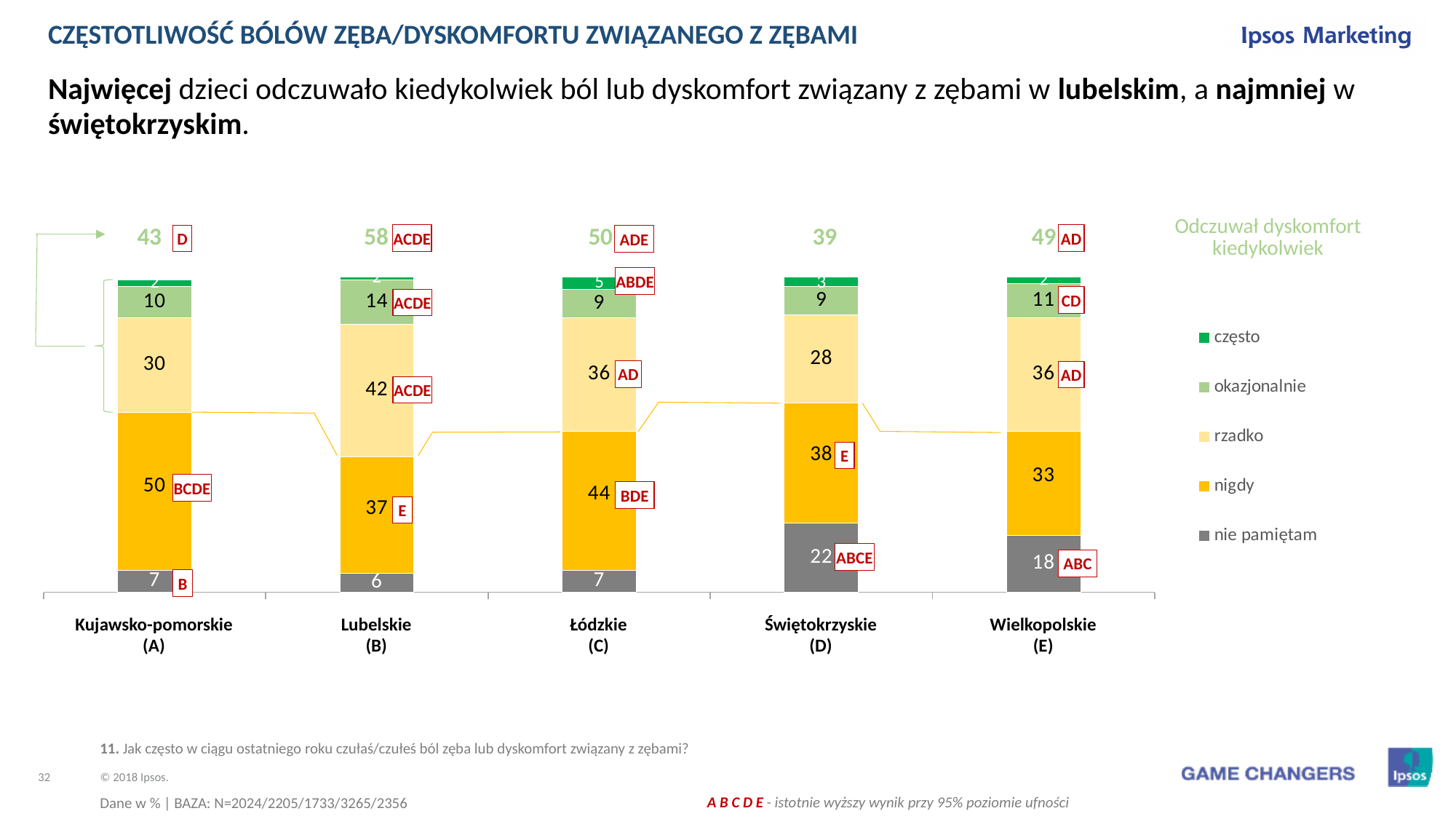
What is the value for 'nie pamiętam' in Świętokrzyskie (D)? 22 Which has the larger 'nie pamiętam' value, Świętokrzyskie (D) or Wielkopolskie (E)? Świętokrzyskie (D) Which region has the highest 'Odczuwał dyskomfort kiedykolwiek' value? Lubelskie (B) Which region has the lowest 'Odczuwał dyskomfort kiedykolwiek' value? Świętokrzyskie (D) How many regions are shown on the x axis? 5 What is the difference between the 'nigdy' values for Kujawsko-pomorskie (A) and Wielkopolskie (E)? 17 How many series does the legend list? 5 What is the value for 'rzadko' in Lubelskie (B)? 42 What is the 'Odczuwał dyskomfort kiedykolwiek' value shown above the bar for Wielkopolskie (E)? 49 What kind of chart is shown on the slide? Stacked bar chart What is the value for 'nigdy' in Kujawsko-pomorskie (A)? 50 What is the value for 'często' in Łódzkie (C)? 5